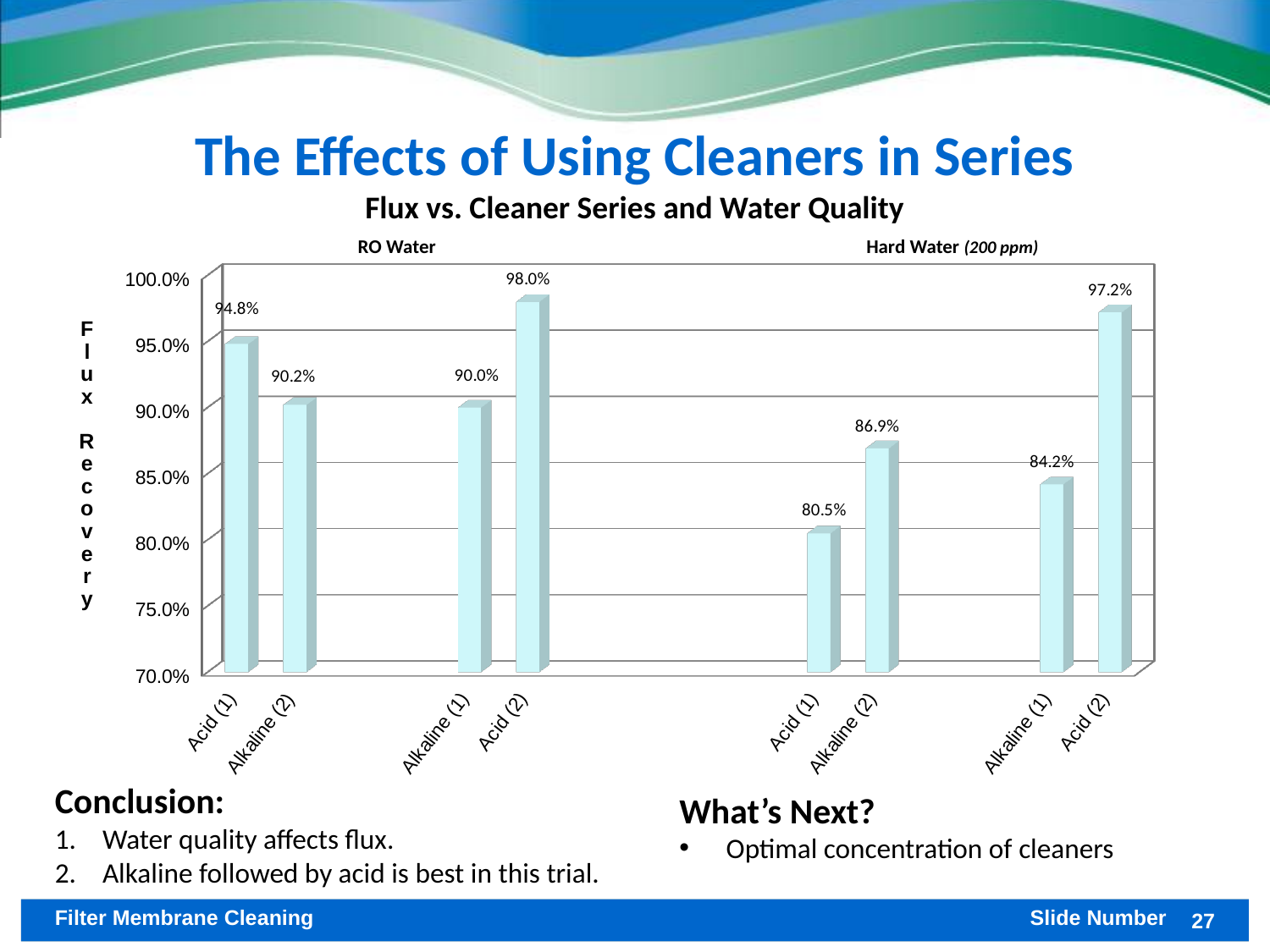
What is the flux recovery for Acid (2) under RO Water? 98.0% What kind of chart is shown on the slide? Bar chart What is the flux recovery for Alkaline (1) under RO Water? 90.0% Which is larger: the flux recovery for Alkaline (1) under Hard Water (200 ppm) or Alkaline (2) under Hard Water (200 ppm)? Alkaline (2) under Hard Water (200 ppm) Which bar has the lowest flux recovery on the chart? Acid (1) under Hard Water (200 ppm) What is the difference in flux recovery between Acid (2) under RO Water and Acid (2) under Hard Water (200 ppm)? 0.8% How many bars are plotted on the chart? 8 What is the title of the chart? Flux vs. Cleaner Series and Water Quality What is the difference in flux recovery between Acid (1) under RO Water and Acid (1) under Hard Water (200 ppm)? 14.3% Which bar has the highest flux recovery on the chart? Acid (2) under RO Water What is the flux recovery for Acid (1) under Hard Water (200 ppm)? 80.5% What is the flux recovery for Alkaline (2) under Hard Water (200 ppm)? 86.9%